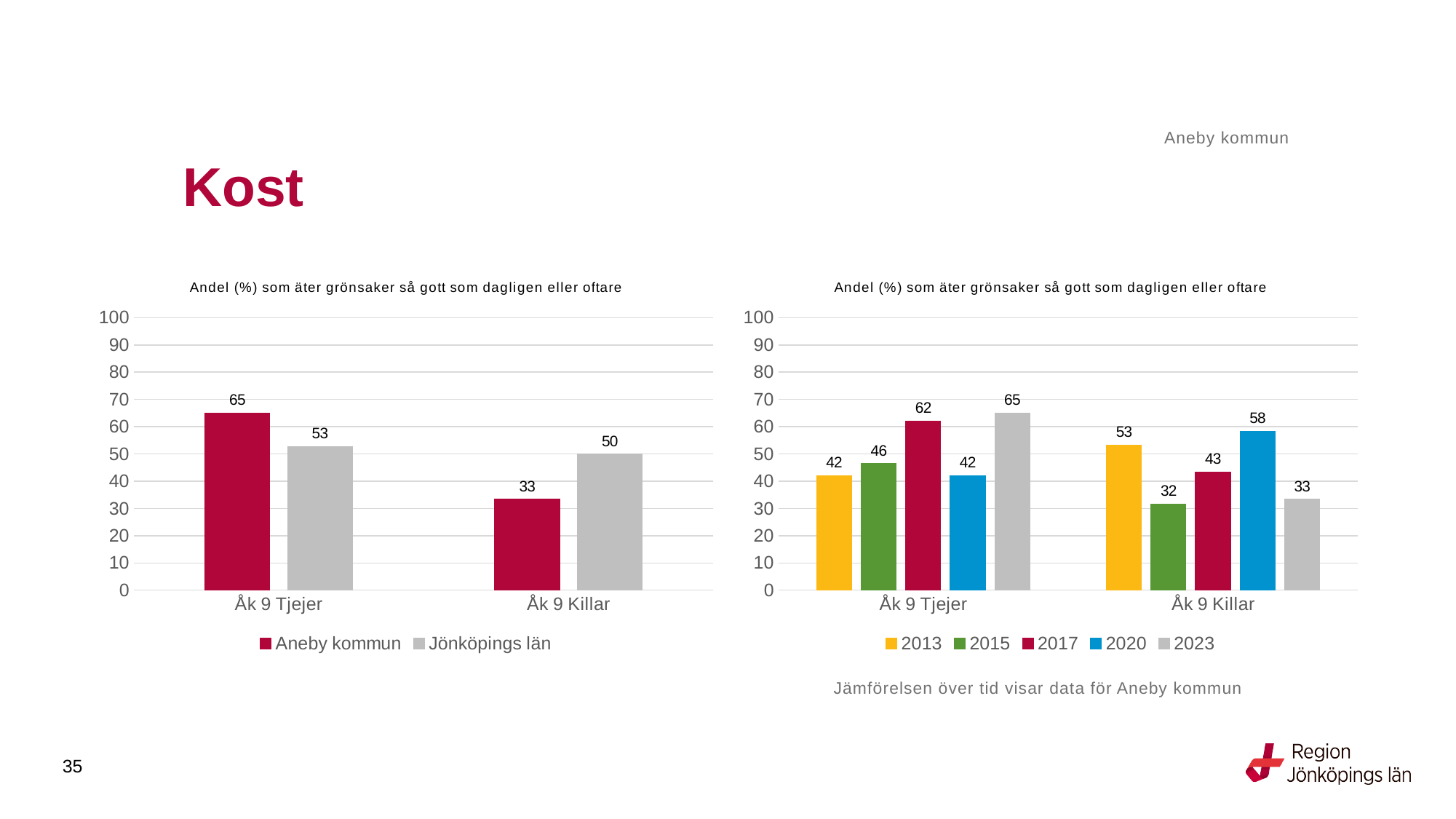
In the right chart, what is the value for 2017 for Åk 9 Tjejer? 62 In the left chart, what is the value for Jönköpings län for Åk 9 Killar? 50 In the right chart, which year has the highest value for Åk 9 Tjejer? 2023 What kind of chart is the right chart? Bar chart In the right chart, which year has the lowest value for Åk 9 Killar? 2015 In the right chart, how many series does the legend list? 5 In the left chart, which is larger for Åk 9 Tjejer: Aneby kommun or Jönköpings län? Aneby kommun In the left chart, what is the value for Aneby kommun for Åk 9 Tjejer? 65 In the right chart, what is the value for 2020 for Åk 9 Killar? 58 In the left chart, how many series does the legend list? 2 In the right chart, what is the difference between the 2023 and 2013 values for Åk 9 Tjejer? 23 In the left chart, what is the difference between Aneby kommun and Jönköpings län for Åk 9 Killar? 17